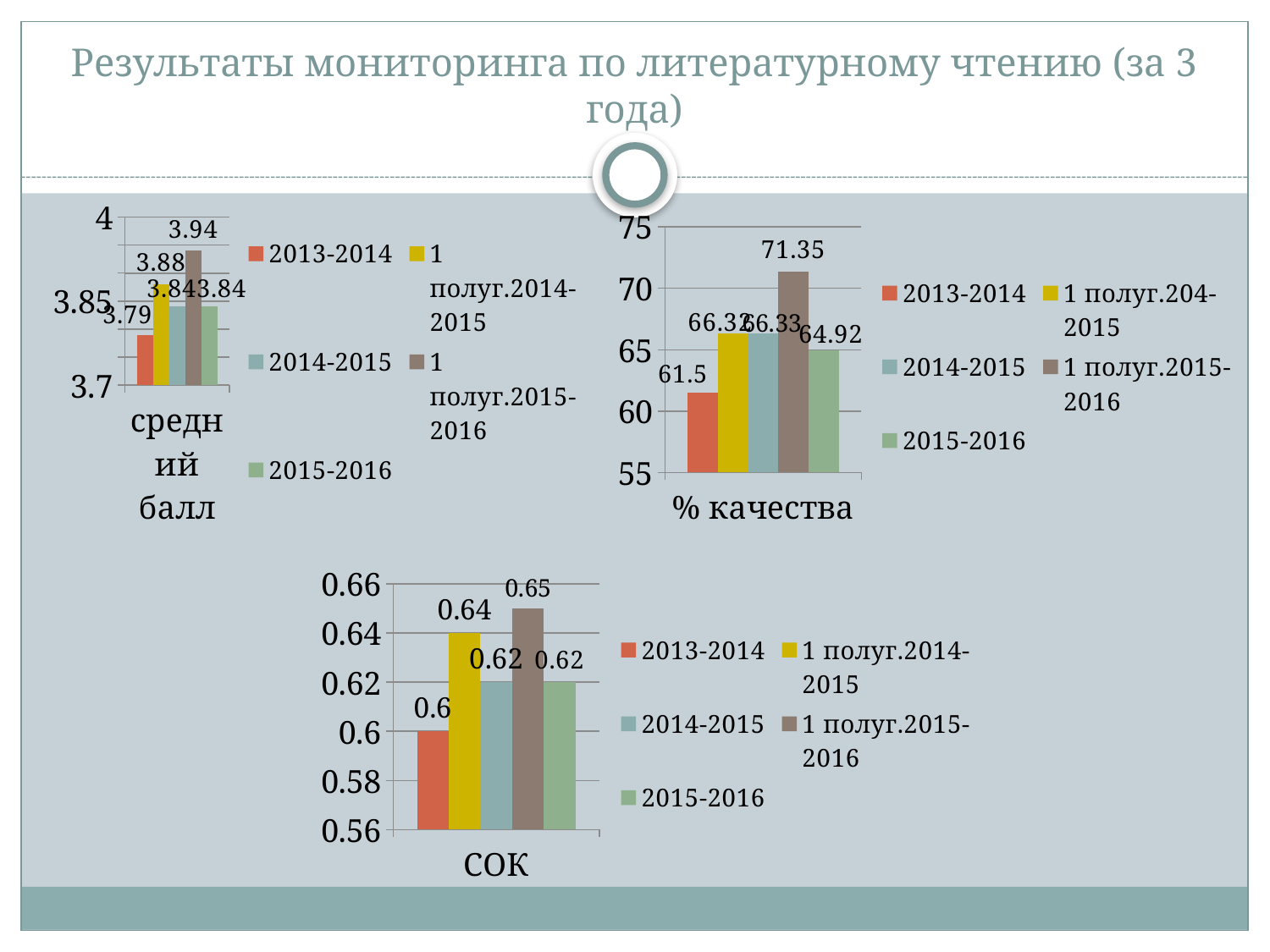
In the '% качества' chart, what is the value for 2013-2014? 61.5 In the '% качества' chart, what is the value for 1 полуг.2015-2016? 71.35 What type of chart is the 'СОК' chart? bar chart In the 'средний балл' chart, what is the value for 2013-2014? 3.79 In the 'СОК' chart, what is the value for 1 полуг.2015-2016? 0.65 How many series does the legend of the 'СОК' chart list? 5 In the '% качества' chart, which series has the lowest value? 2013-2014 In the 'средний балл' chart, which series has the highest value? 1 полуг.2015-2016 In the '% качества' chart, is the value for 2015-2016 greater or less than 65? less In the 'СОК' chart, which is larger, the value for 1 полуг.2014-2015 or the value for 2015-2016? 1 полуг.2014-2015 In the 'средний балл' chart, what is the value for 1 полуг.2015-2016? 3.94 In the 'средний балл' chart, what is the difference between the 1 полуг.2014-2015 value and the 2013-2014 value? 0.09